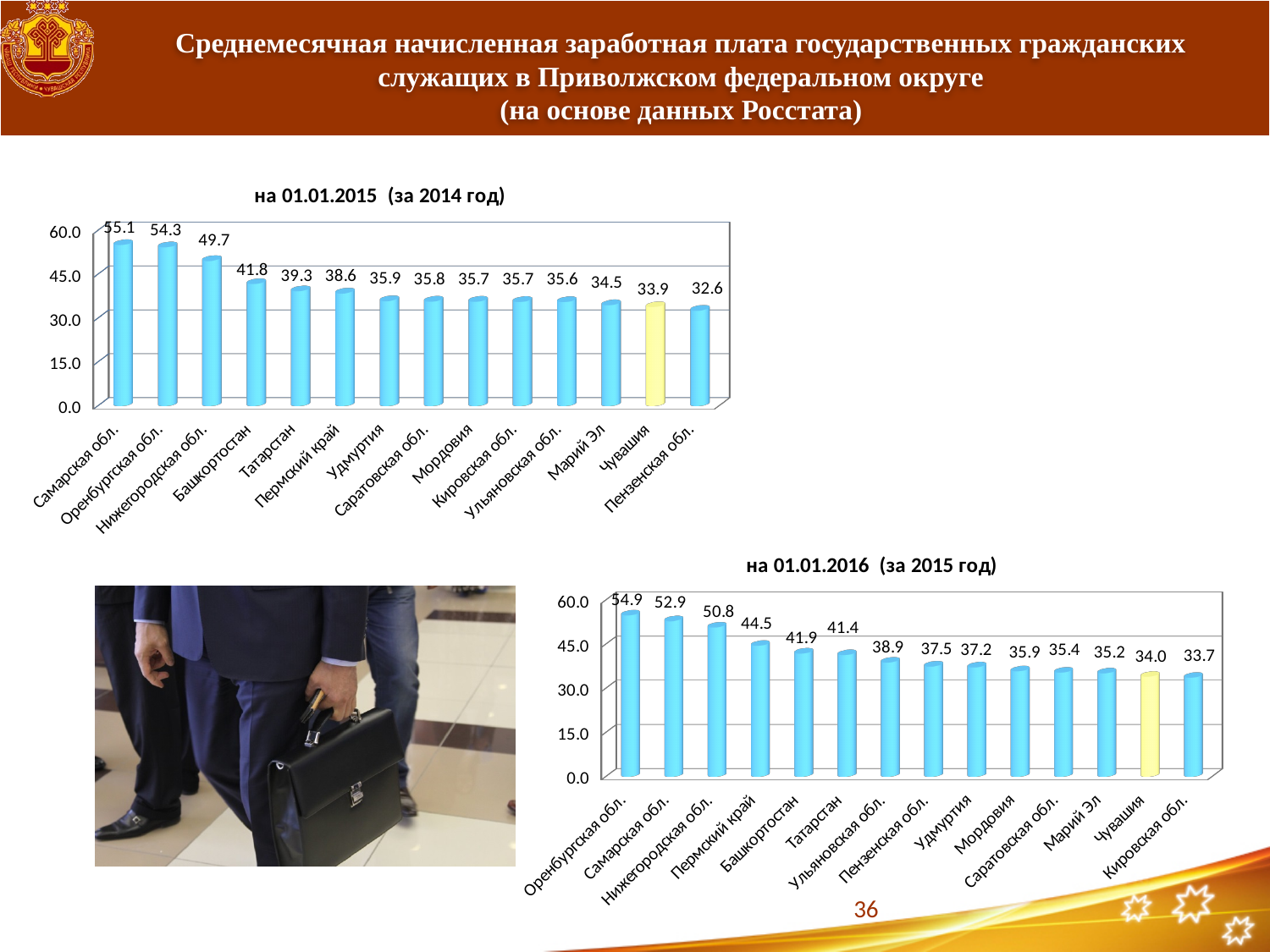
In the chart 'на 01.01.2016 (за 2015 год)', which region has the highest value? Оренбургская обл. In the chart 'на 01.01.2016 (за 2015 год)', which is larger: Татарстан or Башкортостан? Башкортостан In the chart 'на 01.01.2015 (за 2014 год)', do the values rise or fall from left to right? Fall In the chart 'на 01.01.2015 (за 2014 год)', what is the value for Чувашия? 33.9 In the chart 'на 01.01.2016 (за 2015 год)', which region has the lowest value? Кировская обл. In the chart 'на 01.01.2015 (за 2014 год)', which region has the lowest value? Пензенская обл. In the chart 'на 01.01.2015 (за 2014 год)', which region has the highest value? Самарская обл. In the chart 'на 01.01.2016 (за 2015 год)', what is the value for Пермский край? 44.5 In the chart 'на 01.01.2015 (за 2014 год)', how many regions are shown? 14 What kind of chart is 'на 01.01.2016 (за 2015 год)'? Bar chart In the chart 'на 01.01.2015 (за 2014 год)', what is the difference between Самарская обл. and Оренбургская обл.? 0.8 In the chart 'на 01.01.2016 (за 2015 год)', what is the difference between Нижегородская обл. and Чувашия? 16.8